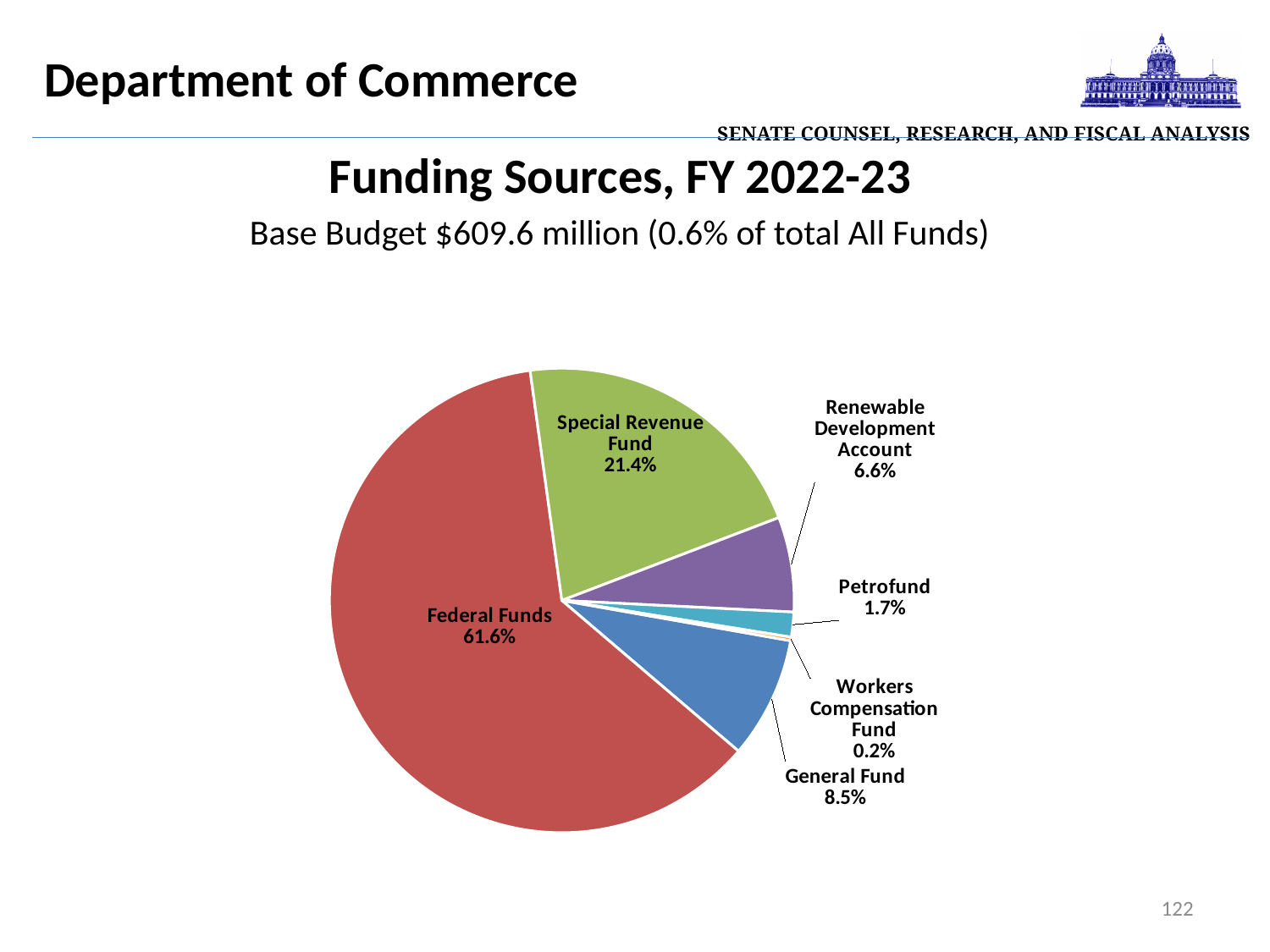
What share of funding comes from the General Fund? 8.5% What share of funding comes from Federal Funds? 61.6% Which funding source has the largest share of the pie? Federal Funds What is the difference in percentage points between the Special Revenue Fund and the General Fund shares? 12.9 Which is larger, the share for the Renewable Development Account or the share for the General Fund? General Fund What share of funding comes from the Workers Compensation Fund? 0.2% What share of funding comes from the Renewable Development Account? 6.6% Which funding source has the smallest share of the pie? Workers Compensation Fund What share of funding comes from the Petrofund? 1.7% What kind of chart is shown on the slide? pie chart How many funding sources are shown in the pie chart? 6 What share of funding comes from the Special Revenue Fund? 21.4%